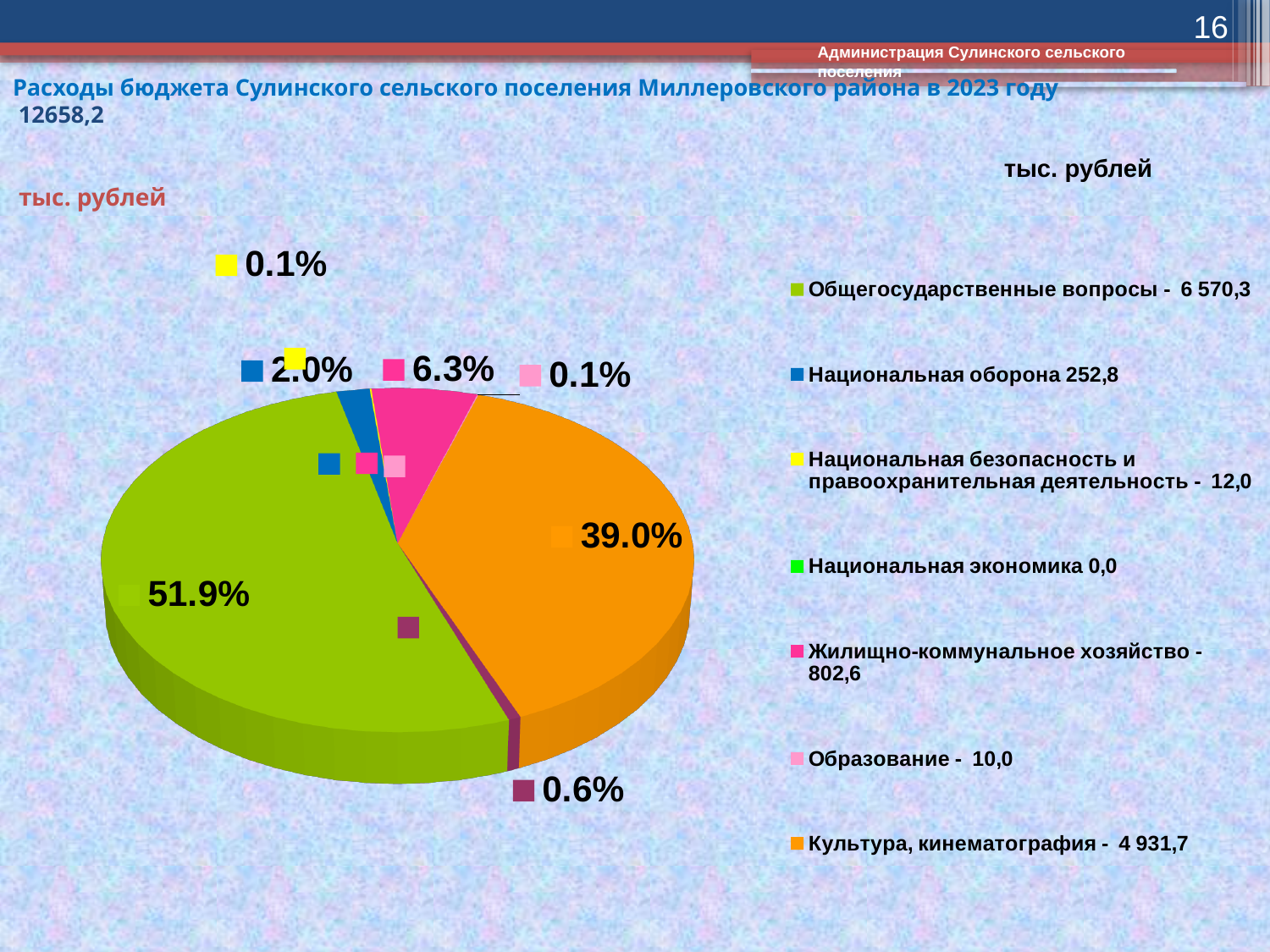
What percentage share does the Жилищно-коммунальное хозяйство slice have? 6.3% What percentage share does the Национальная оборона slice have? 2.0% What amount in thousand rubles is given in the legend for Национальная оборона? 252,8 What kind of chart is shown on the slide? pie chart What is the difference in percentage points between the Общегосударственные вопросы share and the Культура, кинематография share? 12.9 What percentage share does the Общегосударственные вопросы slice have? 51.9% What amount in thousand rubles is given in the legend for Жилищно-коммунальное хозяйство? 802,6 What amount in thousand rubles is given in the legend for Общегосударственные вопросы? 6 570,3 What amount in thousand rubles is given in the legend for Культура, кинематография? 4 931,7 Which is larger, the share for Жилищно-коммунальное хозяйство or the share for Национальная оборона? Жилищно-коммунальное хозяйство Which category has the largest share of the pie? Общегосударственные вопросы